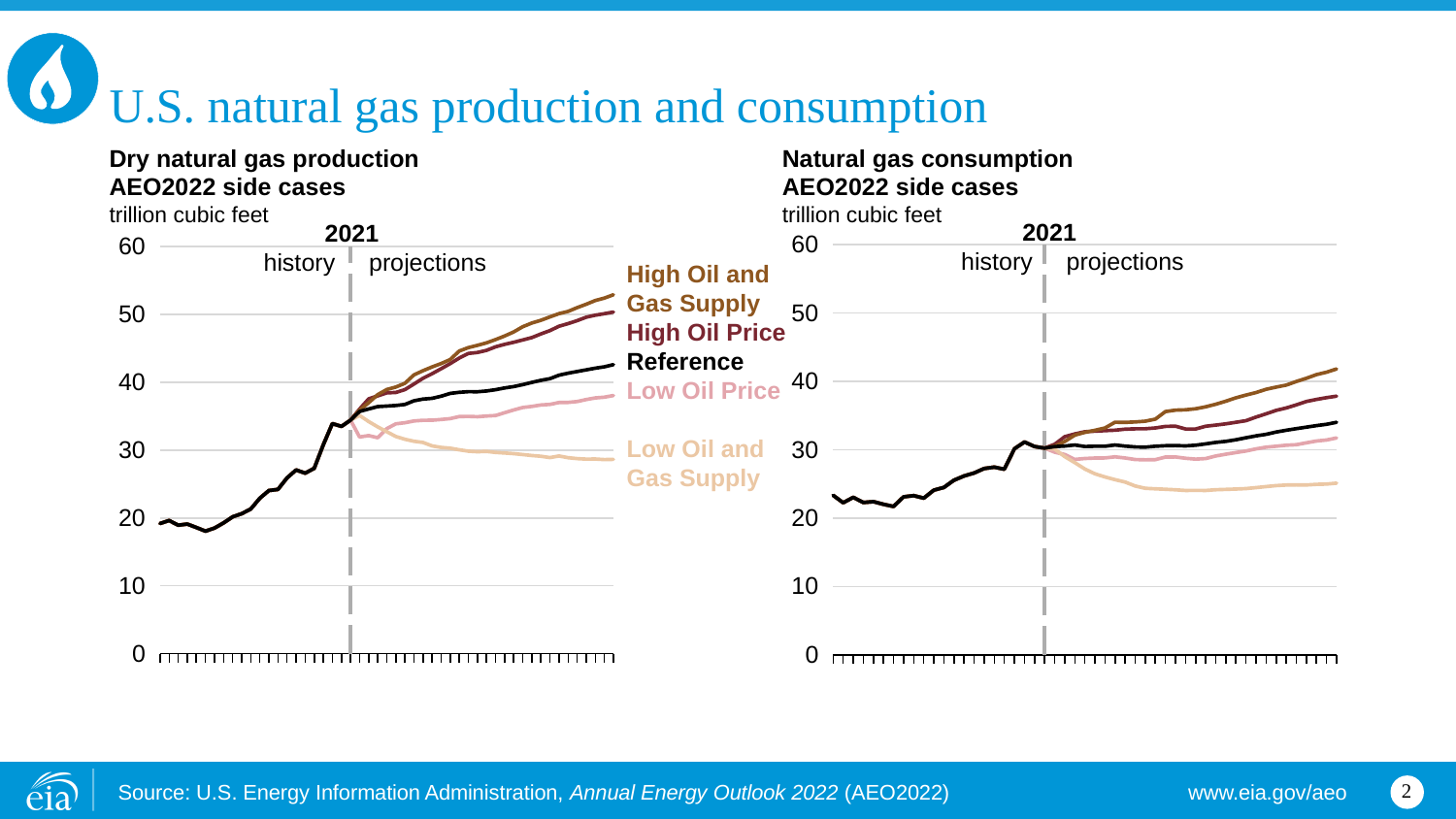
In the 'Natural gas consumption' chart, is the value of the High Oil and Gas Supply case at the end of the projection period greater or less than 40? greater What year does the dashed vertical line separating history from projections mark on both charts? 2021 In the 'Dry natural gas production' chart, which side case is lowest at the end of the projection period? Low Oil and Gas Supply In the 'Natural gas consumption' chart, does the Reference case rise or fall over the projection period? rise In the 'Dry natural gas production' chart, which side case is highest at the end of the projection period? High Oil and Gas Supply How many series (side cases) are labelled on the 'Dry natural gas production' chart? 5 In the 'Natural gas consumption' chart, is the value of the Low Oil and Gas Supply case at the end of the projection period greater or less than 30? less In the 'Dry natural gas production' chart, is the value of the High Oil and Gas Supply case at the end of the projection period greater or less than 50? greater What unit is used on the y axis of both charts? trillion cubic feet What kind of chart is the 'Dry natural gas production' chart? line chart In the 'Dry natural gas production' chart, which is larger at the end of the projection period: the Reference case or the Low Oil Price case? Reference